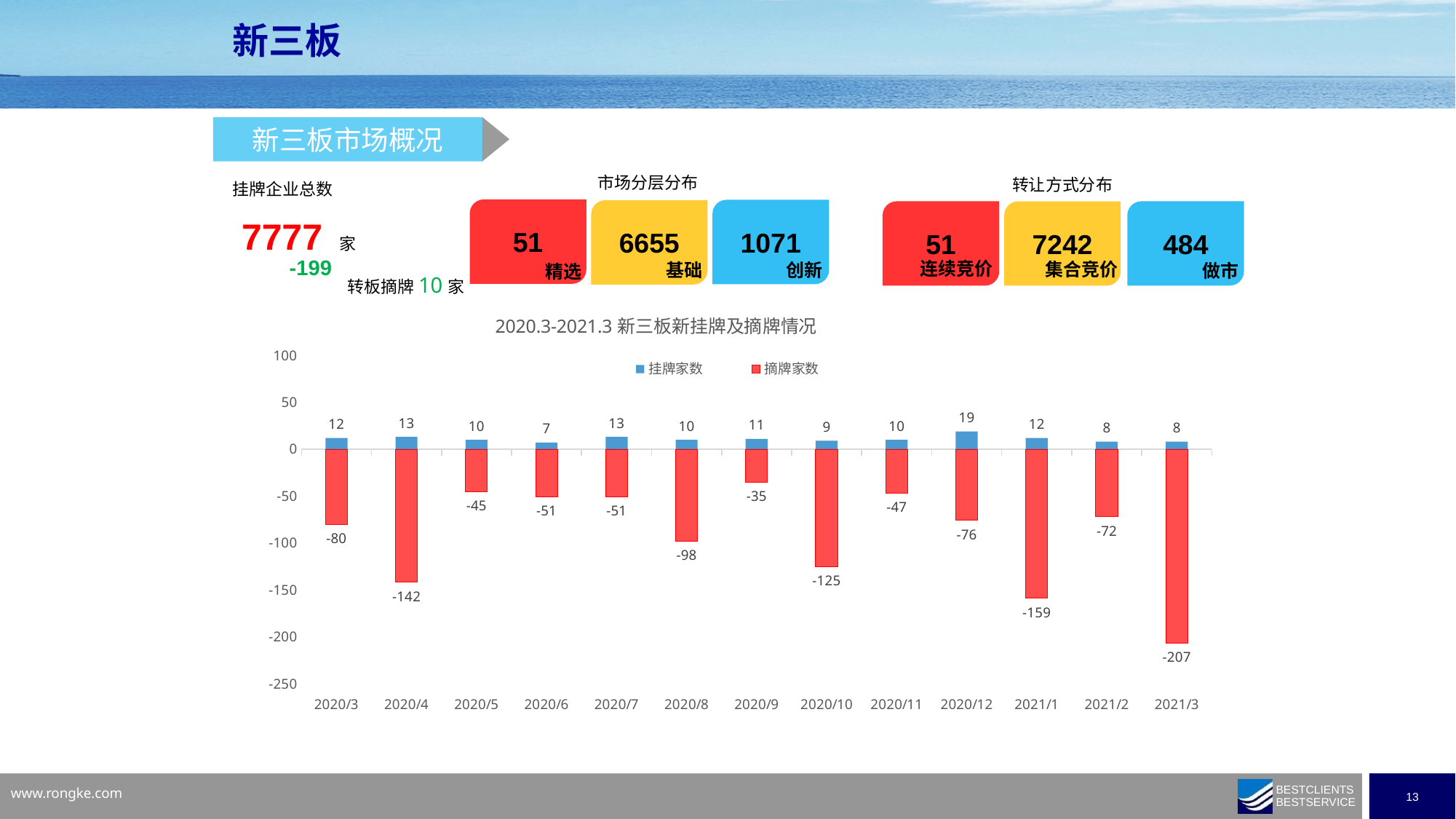
What type of chart is shown on the slide? Bar chart What is the 摘牌家数 value for 2020/4? -142 Which month has the lowest 挂牌家数? 2020/6 What is the difference between the 挂牌家数 for 2020/12 and 2020/6? 12 Which is larger in magnitude, the 摘牌家数 for 2021/1 or for 2020/10? 2021/1 Which month has the smallest (least negative) 摘牌家数? 2020/9 What is the 挂牌家数 value for 2020/12? 19 How many series does the chart legend list? 2 Which month has the highest 挂牌家数? 2020/12 What is the 摘牌家数 value for 2021/3? -207 What is the title of the chart? 2020.3-2021.3 新三板新挂牌及摘牌情况 How many months are shown on the x axis of the chart? 13